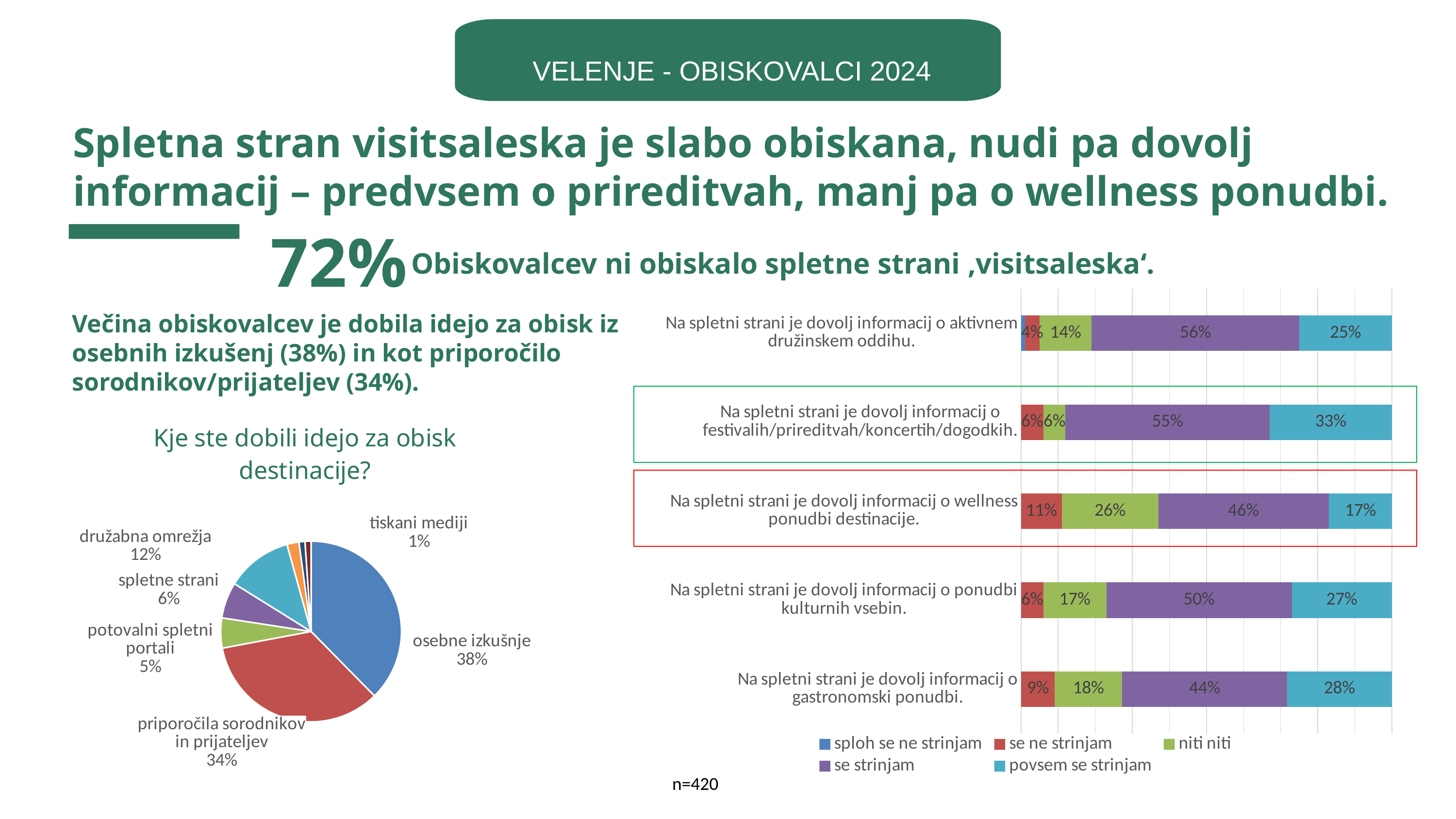
In the stacked bar chart on the right, what is the difference between the 'niti niti' values for the wellness statement and the gastronomski statement? 8% In the pie chart 'Kje ste dobili idejo za obisk destinacije?', what is the difference between 'osebne izkušnje' and 'priporočila sorodnikov in prijateljev'? 4% What kind of chart is the chart on the left of the slide? pie chart In the pie chart 'Kje ste dobili idejo za obisk destinacije?', what share is 'osebne izkušnje'? 38% In the pie chart 'Kje ste dobili idejo za obisk destinacije?', which is larger: 'družabna omrežja' or 'spletne strani'? družabna omrežja In the stacked bar chart on the right, how many series does the legend list? 5 In the stacked bar chart on the right, how many statements (bars) are shown? 5 In the stacked bar chart on the right, what is the 'se ne strinjam' value for 'Na spletni strani je dovolj informacij o wellness ponudbi destinacije.'? 11% In the stacked bar chart on the right, what is the 'se strinjam' value for 'Na spletni strani je dovolj informacij o aktivnem družinskem oddihu.'? 56% In the pie chart 'Kje ste dobili idejo za obisk destinacije?', which labelled slice is the largest? osebne izkušnje In the pie chart 'Kje ste dobili idejo za obisk destinacije?', which labelled slice is the smallest? tiskani mediji In the stacked bar chart on the right, which statement has the highest 'povsem se strinjam' value? Na spletni strani je dovolj informacij o festivalih/prireditvah/koncertih/dogodkih.